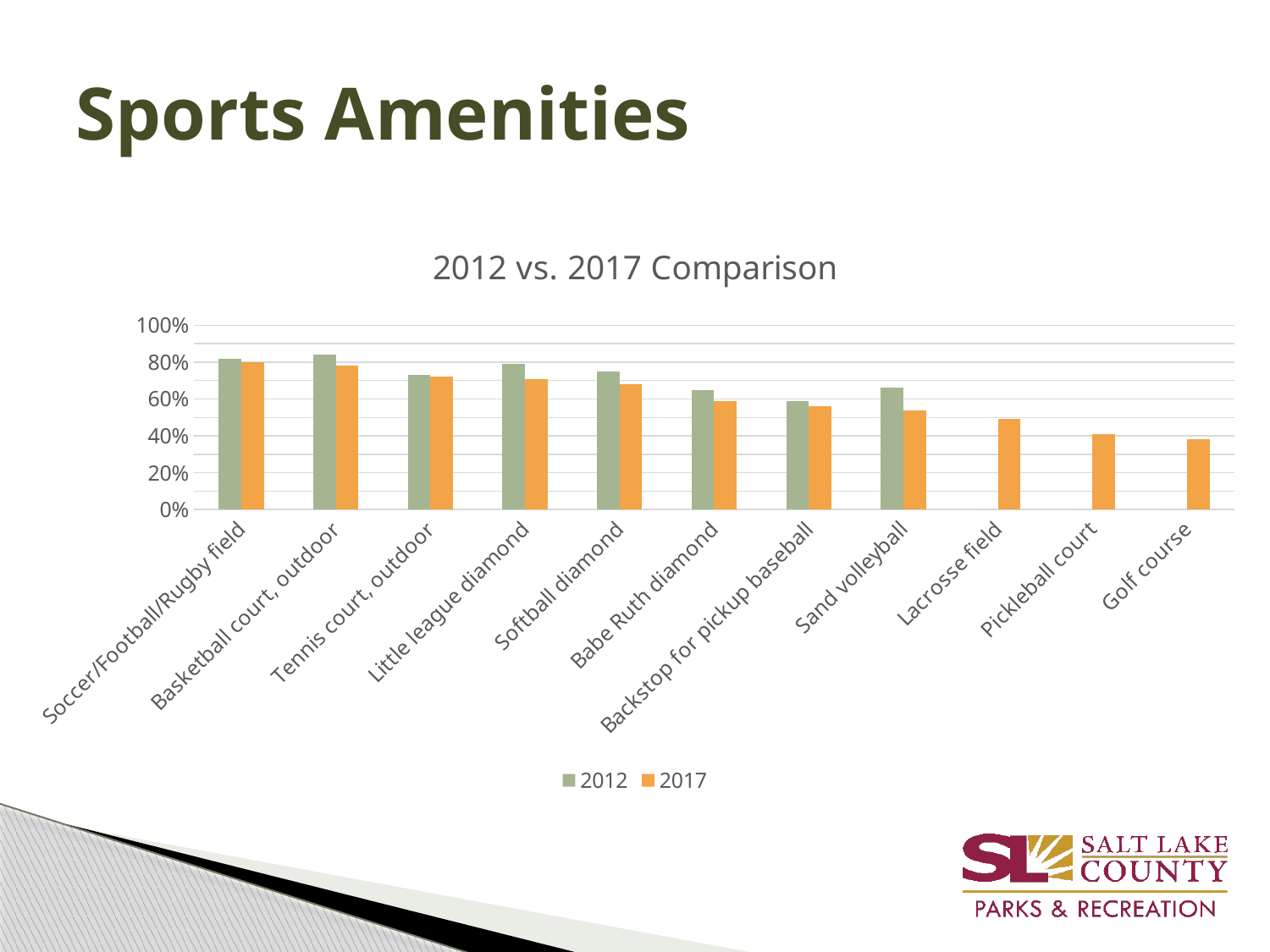
What kind of chart is shown on the slide? Bar chart Is the 2012 value for Basketball court, outdoor greater or less than 80%? greater Which categories have a 2017 bar but no 2012 bar? Lacrosse field, Pickleball court, Golf course Is the 2017 value for Lacrosse field greater or less than 40%? greater For Basketball court, outdoor, which is larger: the 2012 value or the 2017 value? 2012 Do the 2017 values generally rise or fall moving from left to right along the x axis? fall How many series does the legend list? 2 How many categories are shown on the x axis? 11 For Sand volleyball, which is larger: the 2012 value or the 2017 value? 2012 What is the title of the chart? 2012 vs. 2017 Comparison Is the 2017 value for Sand volleyball greater or less than 60%? less